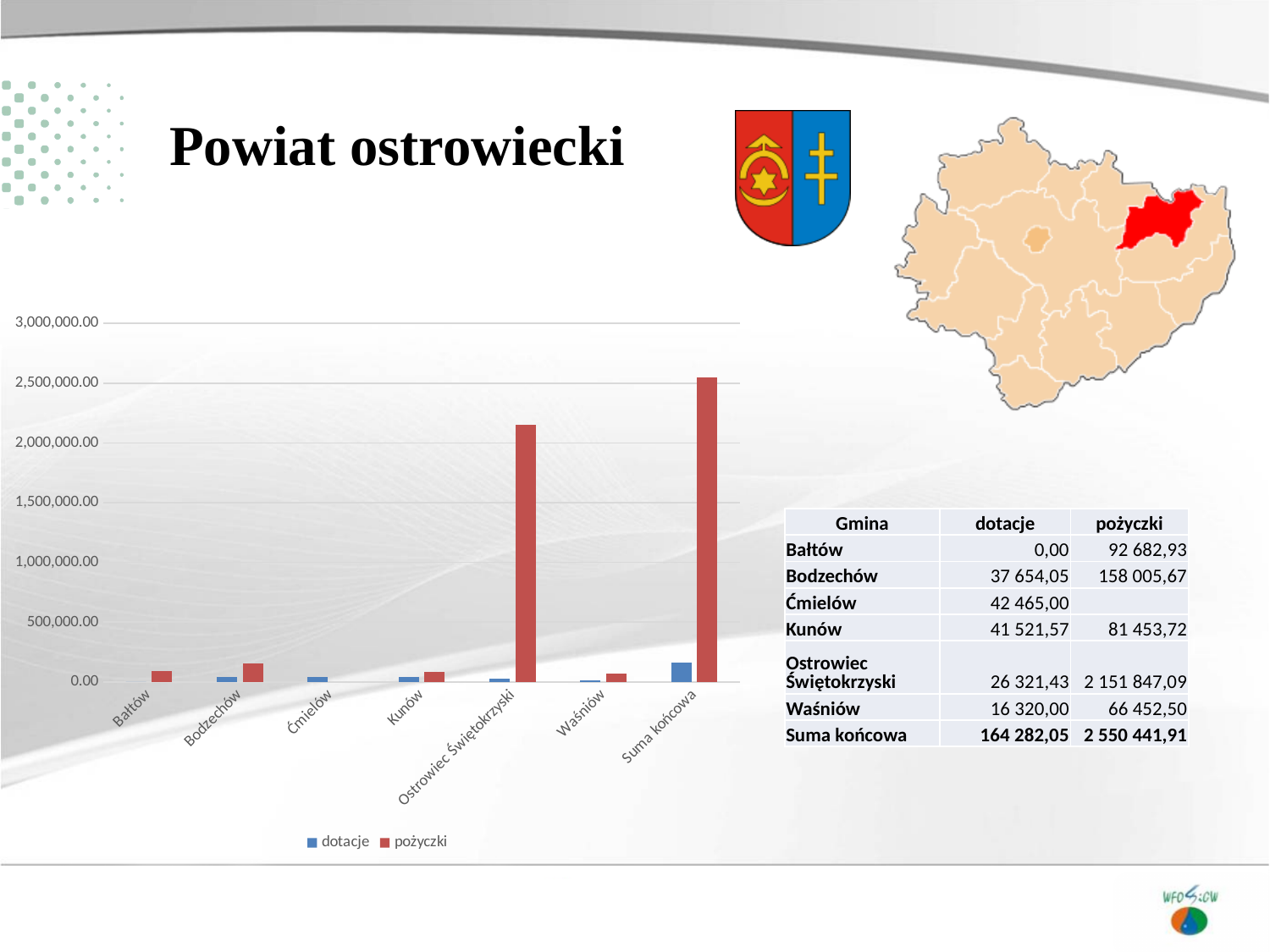
What are the two series named in the chart legend? dotacje and pożyczki What type of chart is shown on the slide? bar chart What is the pożyczki value for Ostrowiec Świętokrzyski? 2 151 847,09 How many series does the chart legend list? 2 What is the difference between the pożyczki and dotacje values for Bodzechów? 120 351,62 Is the pożyczki value for Bodzechów greater or less than 500,000.00? less For Kunów, which is larger: dotacje or pożyczki? pożyczki Which category has the tallest pożyczki bar among the individual gminas (excluding Suma końcowa)? Ostrowiec Świętokrzyski What is the dotacje value for Suma końcowa? 164 282,05 Is the pożyczki value for Ostrowiec Świętokrzyski greater or less than 2,000,000.00? greater Which gmina has the lowest dotacje value? Bałtów How many categories are shown on the x axis of the chart? 7